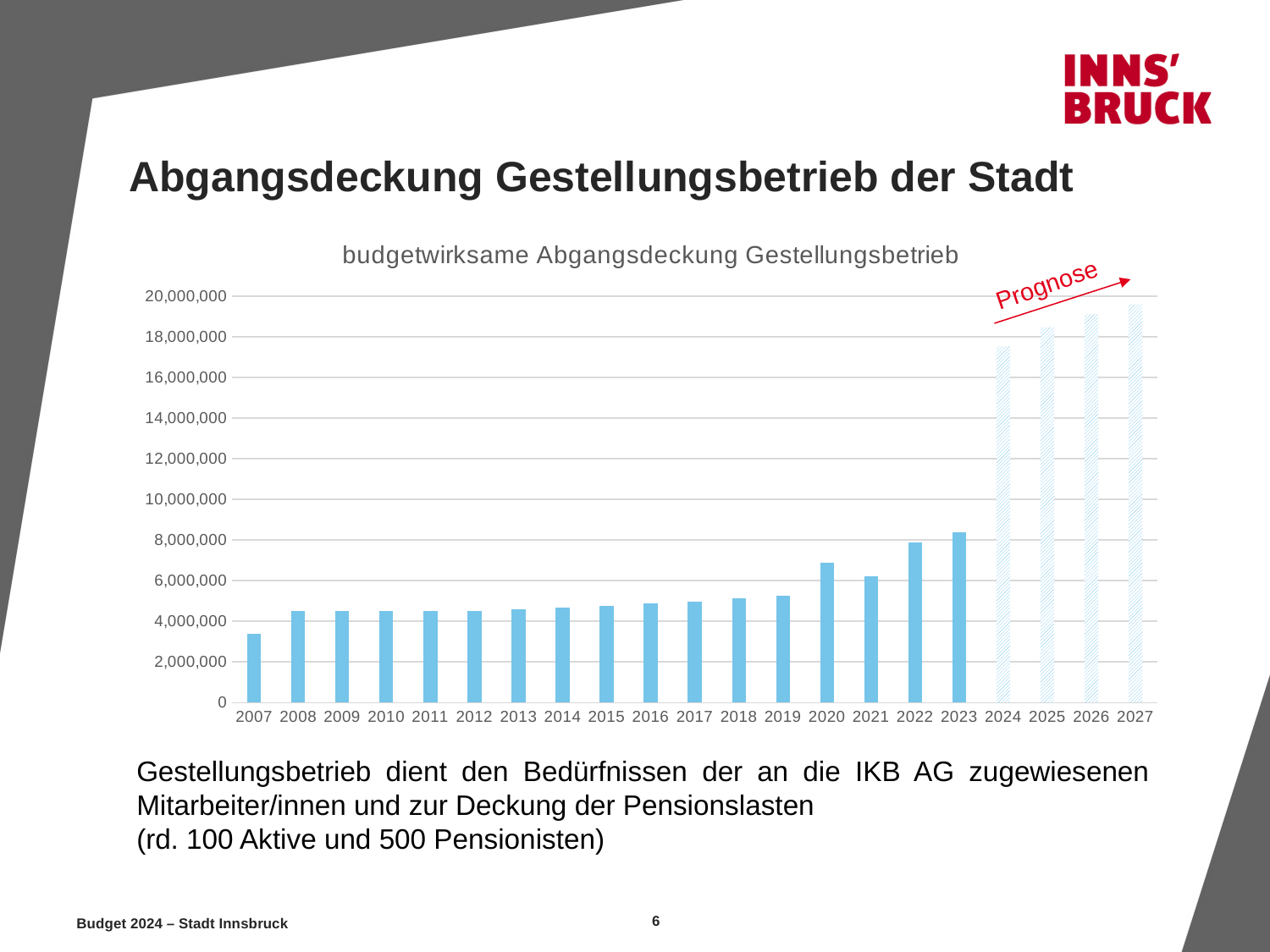
Is the value for 2020 greater or less than 6,000,000? greater How many years are shown on the x axis of the chart? 21 Do the values generally rise or fall from 2007 to 2027? rise Which year has the highest value in the chart? 2027 Is the value for 2007 greater or less than 4,000,000? less What label is written in red above the hatched bars on the right of the chart? Prognose What kind of chart is shown on the slide? bar chart Is the value for 2023 greater or less than 10,000,000? less What is the title of the chart? budgetwirksame Abgangsdeckung Gestellungsbetrieb Which year has the larger value, 2020 or 2021? 2020 Which year has the lowest value in the chart? 2007